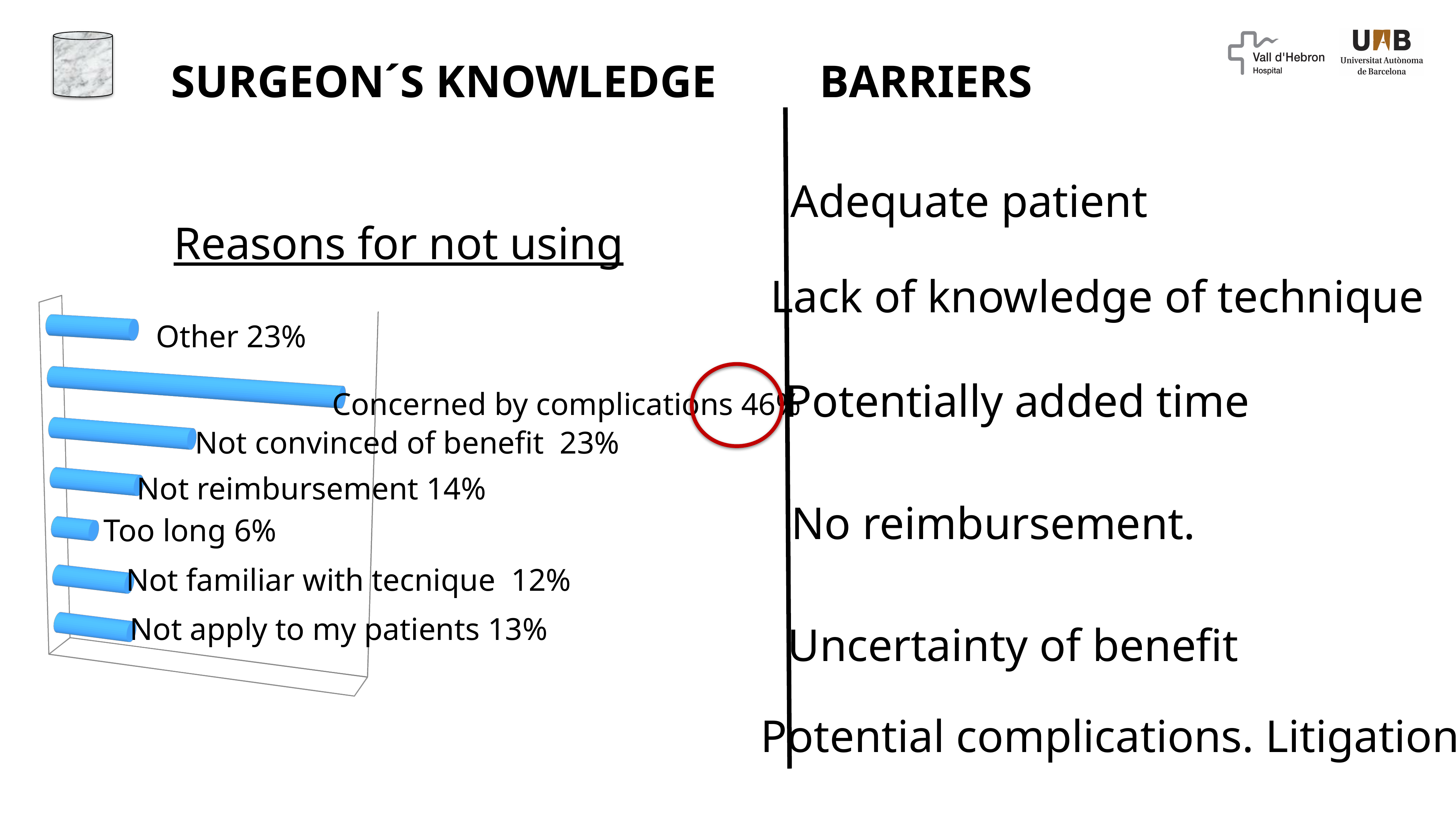
Which reason has the lowest percentage in the Reasons for not using chart? Too long What percentage is shown for "Too long" in the Reasons for not using chart? 6% What is the difference between the percentages for "Concerned by complications" and "Not convinced of benefit"? 23% What percentage is shown for "Not apply to my patients" in the Reasons for not using chart? 13% What percentage is shown for "Not convinced of benefit" in the Reasons for not using chart? 23% What type of chart is used to show the Reasons for not using? Bar chart Which reason has the highest percentage in the Reasons for not using chart? Concerned by complications How many reasons (bars) are shown in the Reasons for not using chart? 7 What percentage is shown for "Not reimbursement" in the Reasons for not using chart? 14% Which is larger in the Reasons for not using chart: "Not reimbursement" or "Not apply to my patients"? Not reimbursement What percentage is shown for "Not familiar with tecnique" in the Reasons for not using chart? 12% What is the title of the chart on the slide? Reasons for not using